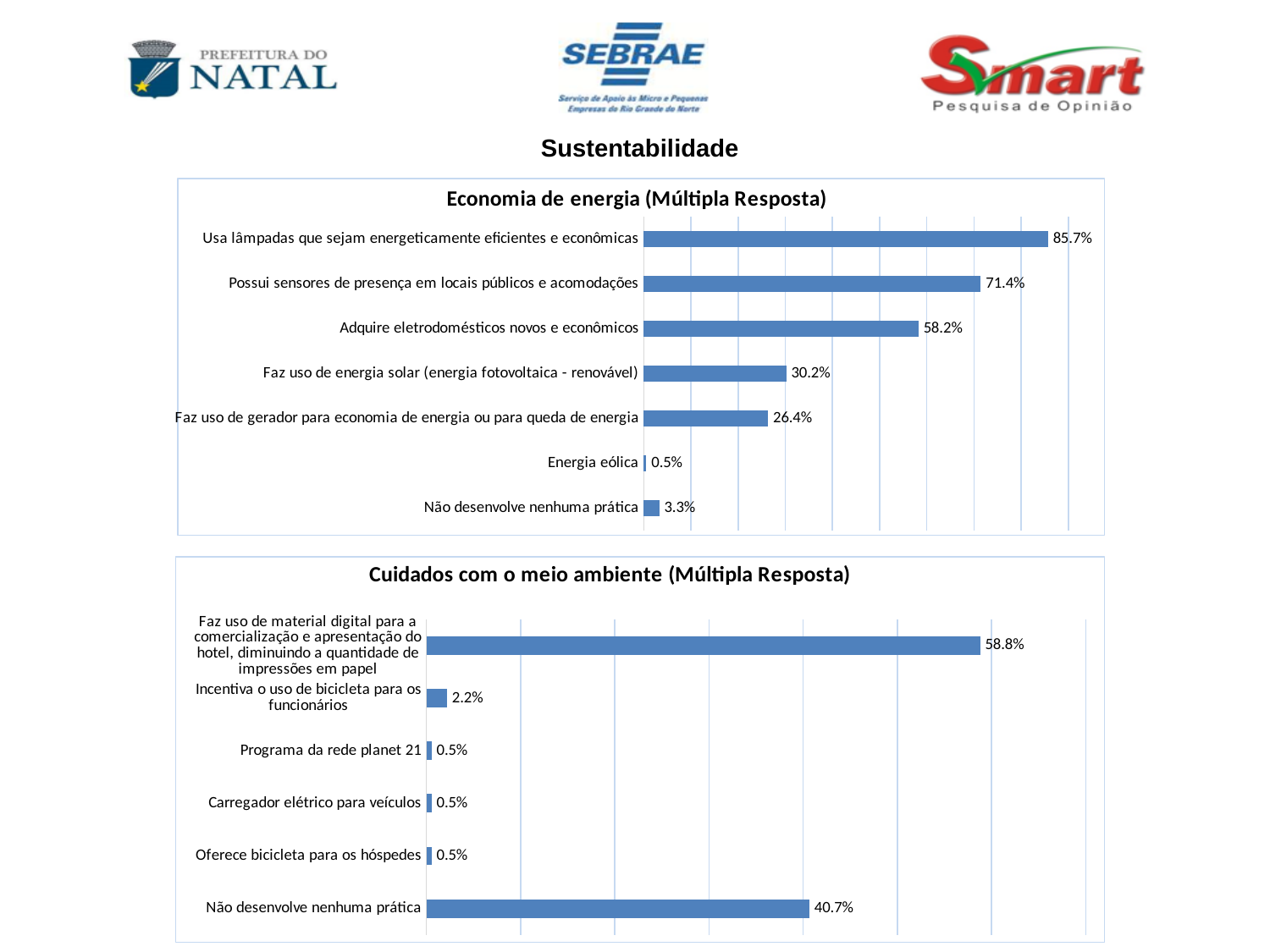
In the 'Economia de energia (Múltipla Resposta)' chart, what is the difference between 'Possui sensores de presença em locais públicos e acomodações' and 'Adquire eletrodomésticos novos e econômicos'? 13.2% In the 'Cuidados com o meio ambiente (Múltipla Resposta)' chart, what is the difference between the highest value and 'Não desenvolve nenhuma prática'? 18.1% In the 'Economia de energia (Múltipla Resposta)' chart, what is the value for 'Usa lâmpadas que sejam energeticamente eficientes e econômicas'? 85.7% In the 'Cuidados com o meio ambiente (Múltipla Resposta)' chart, which category has the highest value? Faz uso de material digital para a comercialização e apresentação do hotel, diminuindo a quantidade de impressões em papel In the 'Economia de energia (Múltipla Resposta)' chart, what is the value for 'Faz uso de energia solar (energia fotovoltaica - renovável)'? 30.2% In the 'Cuidados com o meio ambiente (Múltipla Resposta)' chart, what is the value for 'Não desenvolve nenhuma prática'? 40.7% In the 'Economia de energia (Múltipla Resposta)' chart, how many categories are shown? 7 In the 'Economia de energia (Múltipla Resposta)' chart, which is larger: 'Faz uso de energia solar (energia fotovoltaica - renovável)' or 'Faz uso de gerador para economia de energia ou para queda de energia'? Faz uso de energia solar (energia fotovoltaica - renovável) In the 'Cuidados com o meio ambiente (Múltipla Resposta)' chart, what is the value for 'Incentiva o uso de bicicleta para os funcionários'? 2.2% What type of chart is the 'Economia de energia (Múltipla Resposta)' chart? Bar chart In the 'Cuidados com o meio ambiente (Múltipla Resposta)' chart, how many categories are shown? 6 In the 'Economia de energia (Múltipla Resposta)' chart, which category has the lowest value? Energia eólica